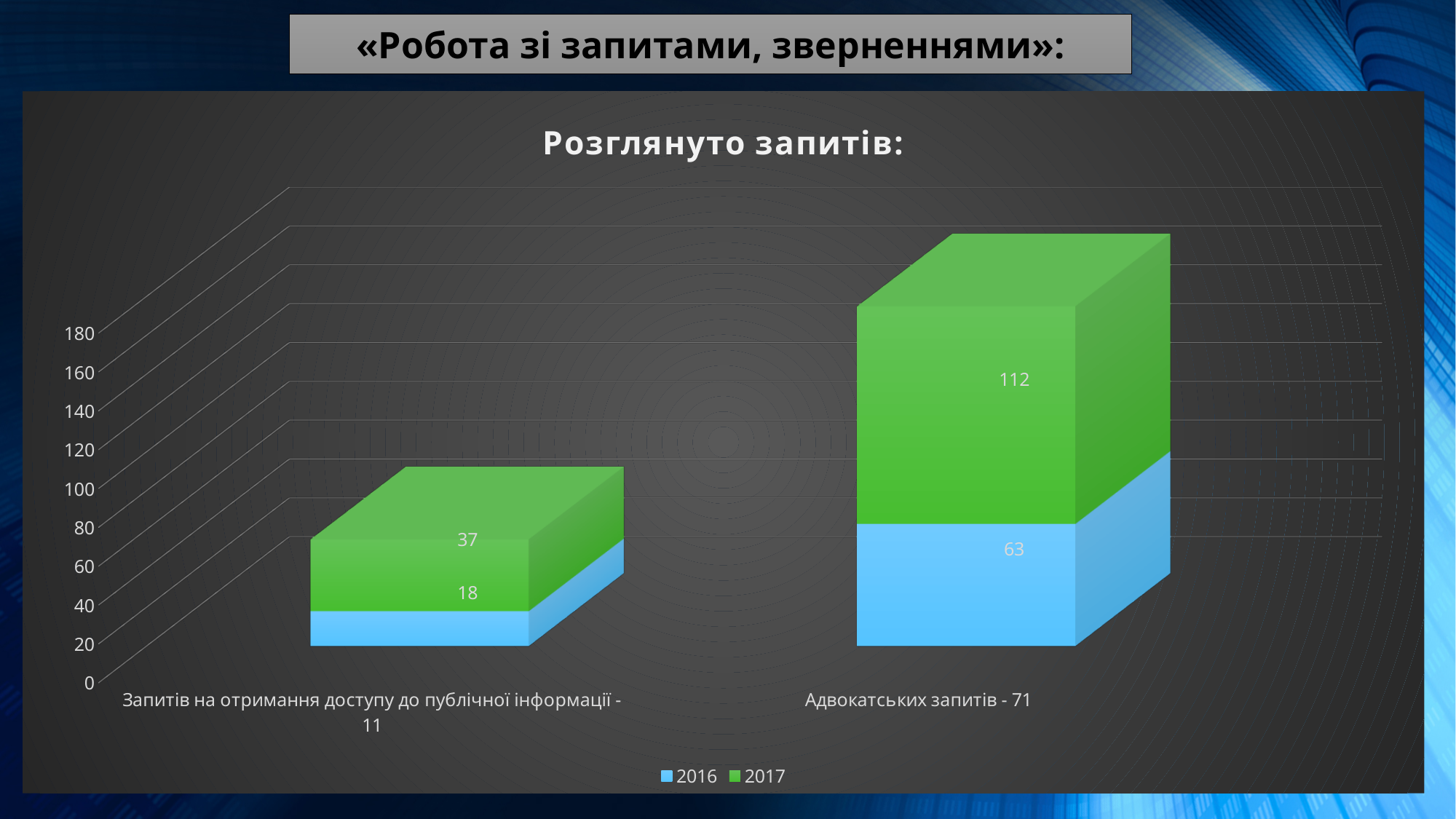
Which category has the highest 2017 value? Адвокатських запитів - 71 Which category has the lowest 2016 value? Запитів на отримання доступу до публічної інформації - 11 What is the 2017 value for "Запитів на отримання доступу до публічної інформації - 11"? 37 What is the total of the stacked bar for "Запитів на отримання доступу до публічної інформації - 11"? 55 What is the 2016 value for "Адвокатських запитів - 71"? 63 Which is larger: the 2016 value for "Адвокатських запитів - 71" or the 2017 value for "Запитів на отримання доступу до публічної інформації - 11"? 2016 value for Адвокатських запитів - 71 What is the total of the stacked bar for "Адвокатських запитів - 71"? 175 What is the difference between the 2017 and 2016 values for "Адвокатських запитів - 71"? 49 How many series does the legend list? 2 What is the 2016 value for "Запитів на отримання доступу до публічної інформації - 11"? 18 What kind of chart is shown on the slide? Stacked bar chart What is the 2017 value for "Адвокатських запитів - 71"? 112